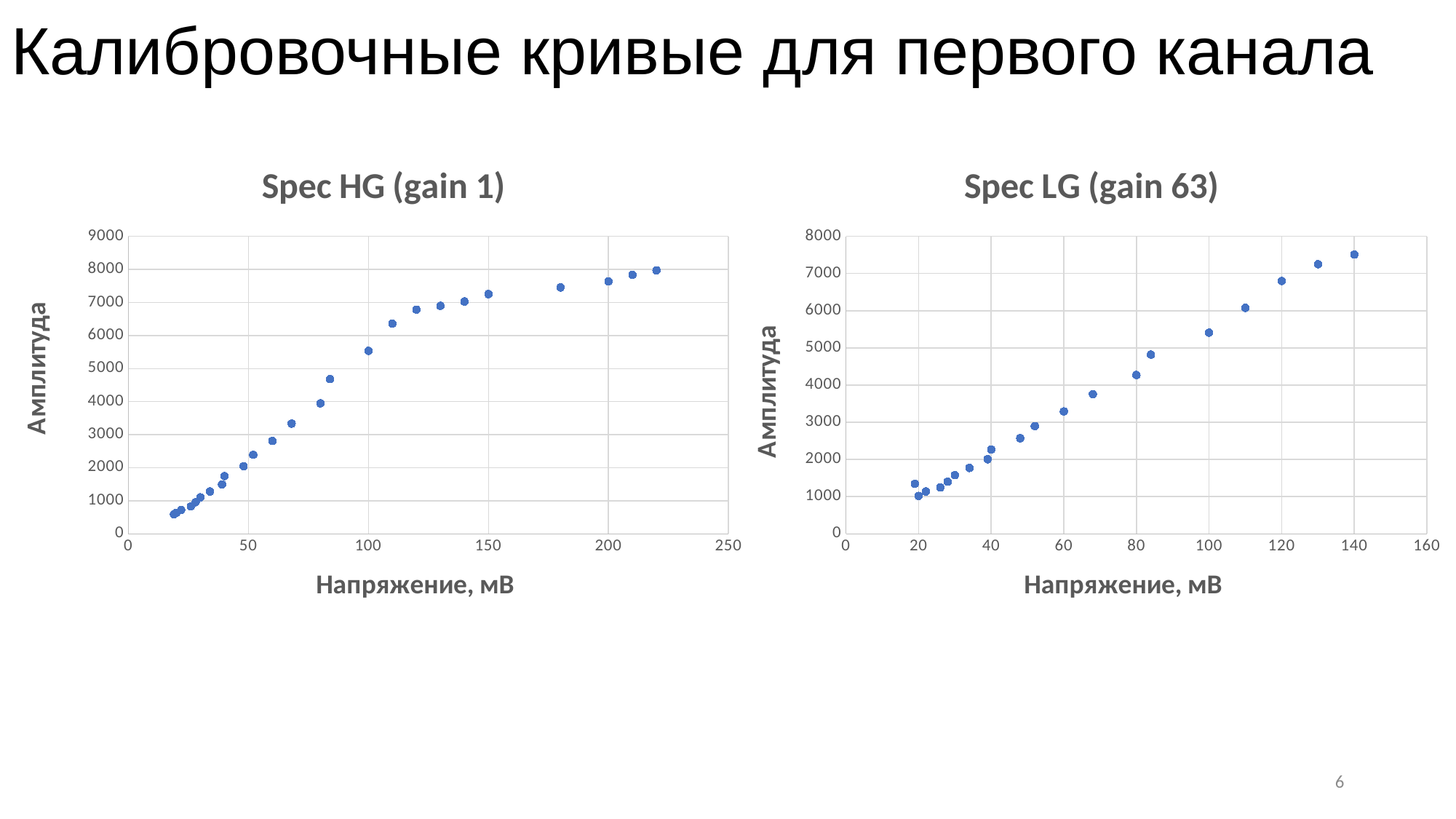
What is the y-axis label of the "Spec LG (gain 63)" chart? Амплитуда In the "Spec LG (gain 63)" chart, is the amplitude at 120 mV greater or less than 7000? less In the "Spec LG (gain 63)" chart, do the amplitude values rise or fall as voltage increases along the x axis? rise What kind of chart is "Spec HG (gain 1)"? scatter chart In the "Spec LG (gain 63)" chart, is the amplitude at 140 mV greater or less than 7000? greater In the "Spec HG (gain 1)" chart, is the amplitude at 200 mV greater or less than 7000? greater In the "Spec HG (gain 1)" chart, do the amplitude values rise or fall as voltage increases along the x axis? rise What kind of chart is "Spec LG (gain 63)"? scatter chart What is the x-axis label of the "Spec HG (gain 1)" chart? Напряжение, мВ